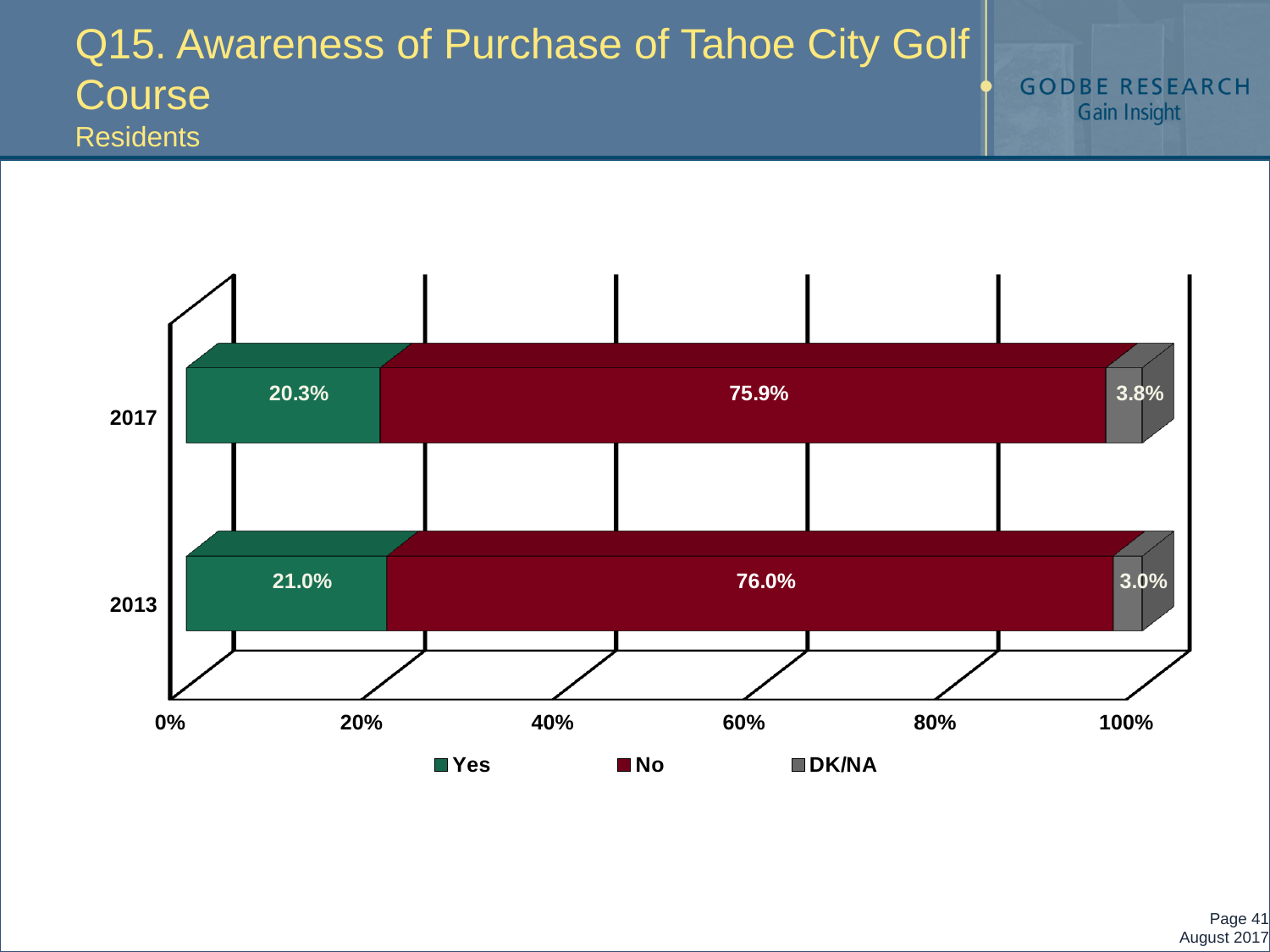
What percentage of residents answered No in 2013? 76.0% What percentage of residents answered Yes in 2017? 20.3% What is the DK/NA value for 2017? 3.8% How many years (categories) are shown on the chart? 2 What is the total of the stacked bar for 2013? 100.0% What is the difference between the No values for 2013 and 2017? 0.1% What kind of chart is shown on the slide? Stacked bar chart Which response category has the lowest value in 2013? DK/NA How many series does the legend list? 3 Which year has the larger DK/NA value, 2017 or 2013? 2017 What is the Yes value for 2013? 21.0% Which response category has the highest value in 2017? No